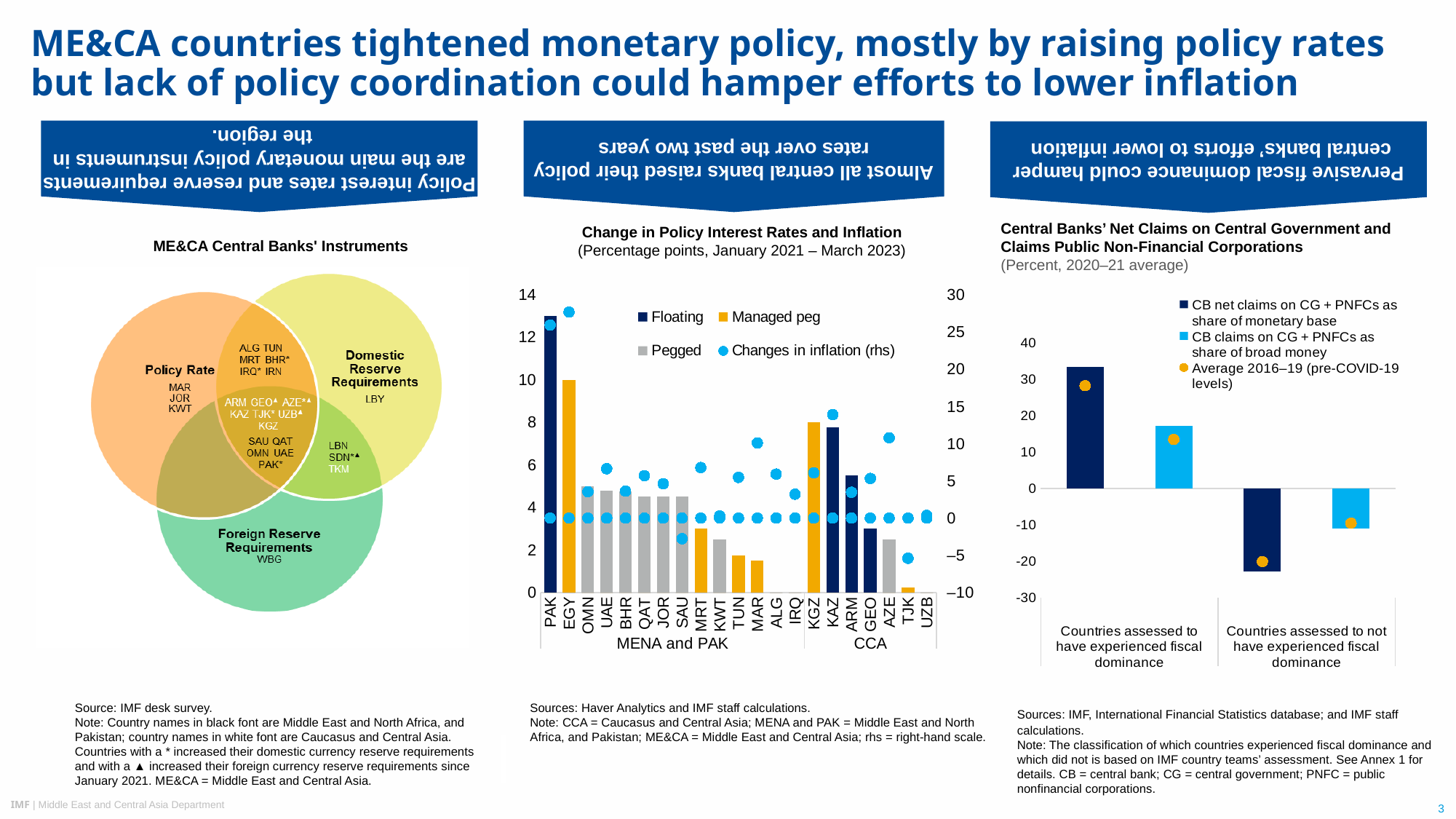
In the 'Change in Policy Interest Rates and Inflation' chart, which country has the tallest bar? PAK What kind of chart is 'Central Banks' Net Claims on Central Government and Claims Public Non-Financial Corporations'? Bar chart In the 'Change in Policy Interest Rates and Inflation' chart, is the bar for MAR greater or less than 2? less How many entries does the legend of the 'Change in Policy Interest Rates and Inflation' chart list? 4 In the 'Change in Policy Interest Rates and Inflation' chart, which bar is taller, KGZ or GEO? KGZ In the 'Change in Policy Interest Rates and Inflation' chart, which bar is taller, EGY or OMN? EGY How many countries are shown on the x axis of the 'Change in Policy Interest Rates and Inflation' chart? 21 In the 'Change in Policy Interest Rates and Inflation' chart, is the bar for KAZ greater or less than 6? greater In the 'Change in Policy Interest Rates and Inflation' chart, is the bar for PAK greater or less than 12? greater In the 'Change in Policy Interest Rates and Inflation' chart, what colour are the bars for countries with a managed peg? Orange